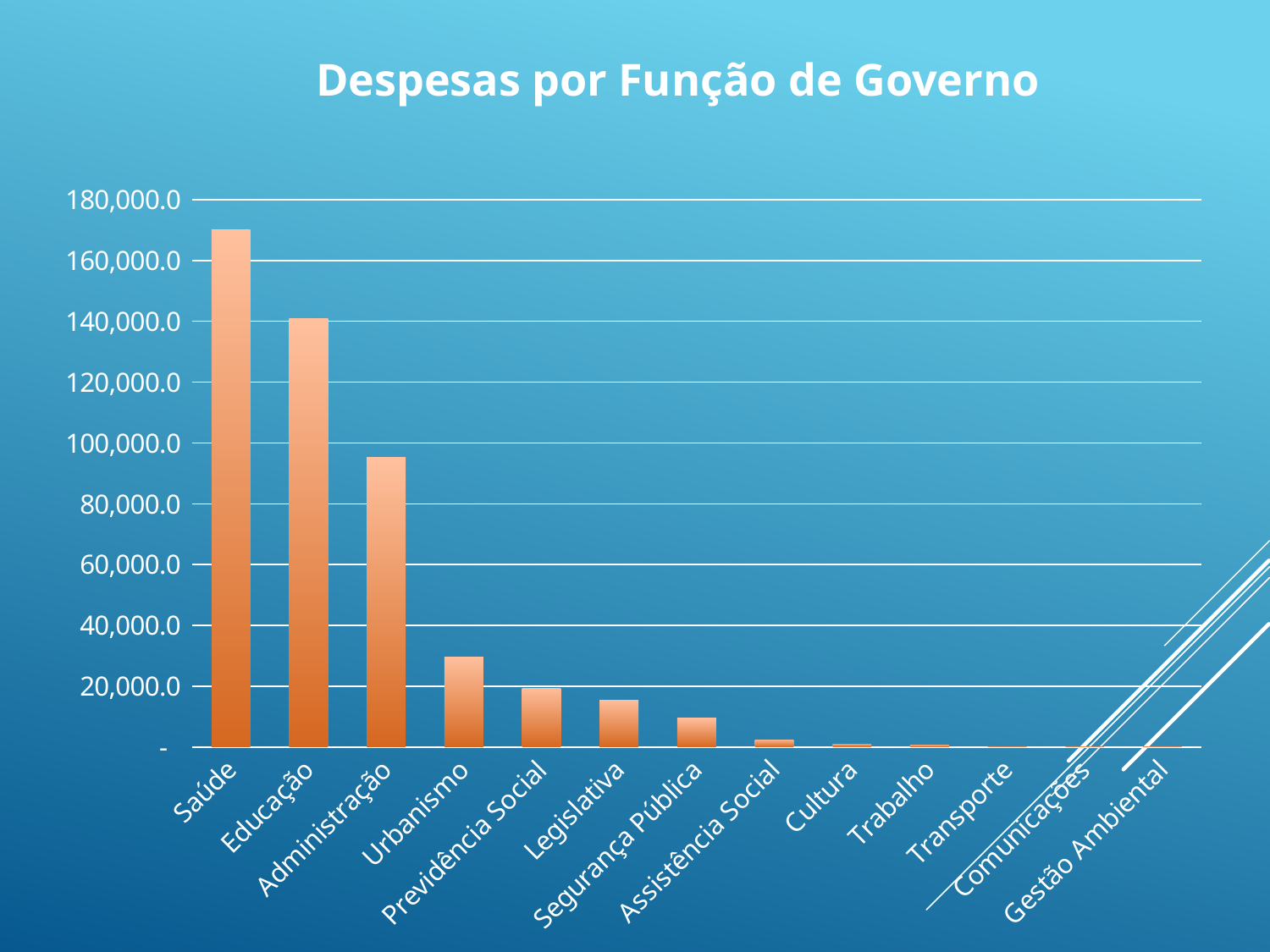
Is the value for Educação greater or less than 160,000.0? less Which category has the highest value in the chart? Saúde Which is larger, the value for Educação or the value for Administração? Educação Is the value for Saúde greater or less than 160,000.0? greater What is the title of the chart? Despesas por Função de Governo What kind of chart is shown on the slide? bar chart Do the values rise or fall moving from left to right along the x axis? fall Which is larger, the value for Legislativa or the value for Urbanismo? Urbanismo How many categories are shown on the x axis of the chart? 13 Is the value for Administração greater or less than 100,000.0? less